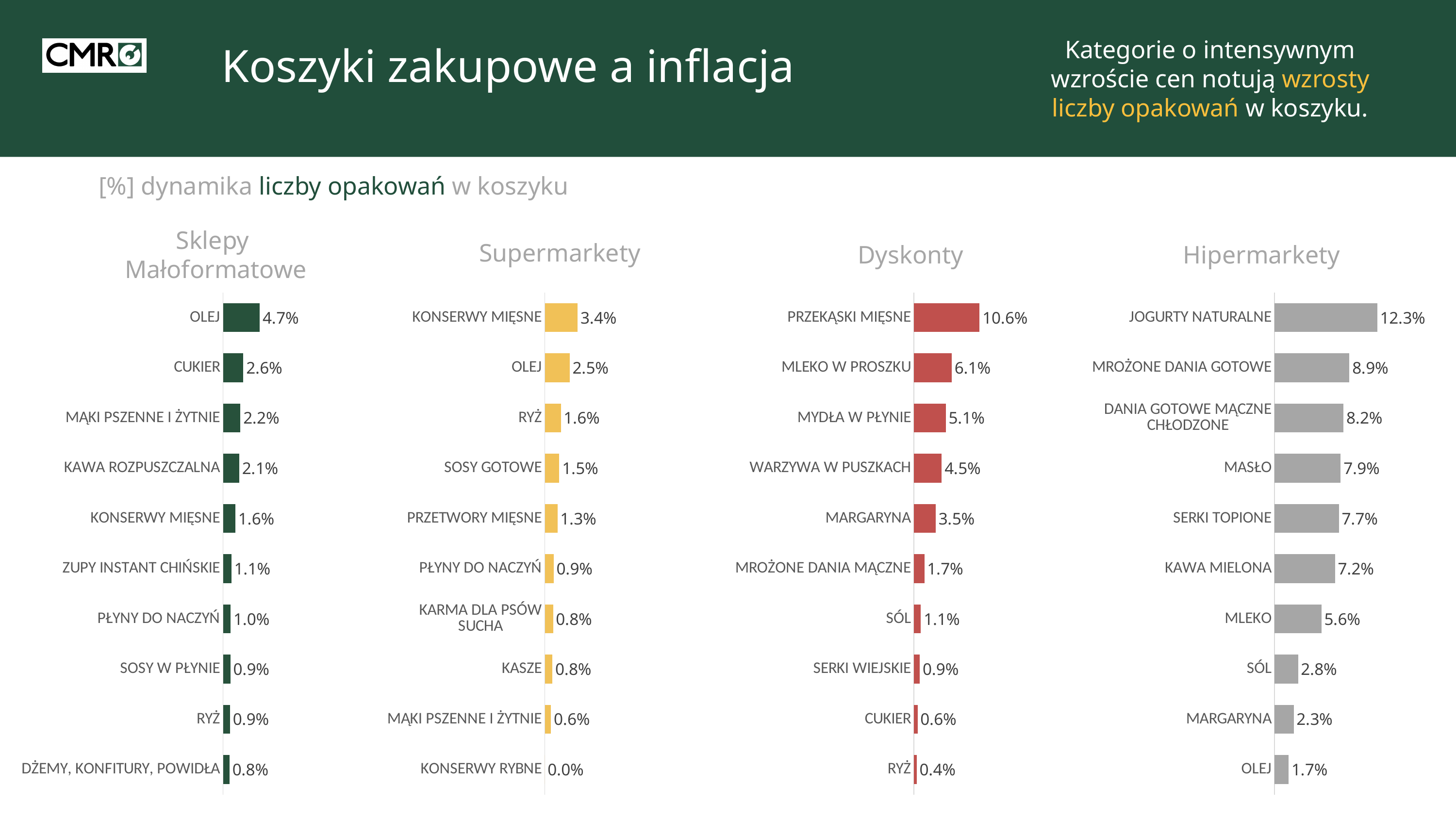
In the Dyskonty chart, which category has the highest value? PRZEKĄSKI MIĘSNE In the Supermarkety chart, what is the value for KONSERWY RYBNE? 0.0% In the Supermarkety chart, which is larger: KONSERWY MIĘSNE or OLEJ? KONSERWY MIĘSNE In the Sklepy Małoformatowe chart, what is the value for KAWA ROZPUSZCZALNA? 2.1% In the Hipermarkety chart, what is the difference between JOGURTY NATURALNE and MROŻONE DANIA GOTOWE? 3.4% What colour are the bars in the Dyskonty chart? Red In the Hipermarkety chart, which category has the lowest value? OLEJ How many categories are shown in the Dyskonty chart? 10 In the Hipermarkety chart, what is the value for MASŁO? 7.9% In the Sklepy Małoformatowe chart, what is the value for OLEJ? 4.7% In the Dyskonty chart, what is the difference between MLEKO W PROSZKU and MYDŁA W PŁYNIE? 1.0% What type of chart is the Hipermarkety chart? Bar chart